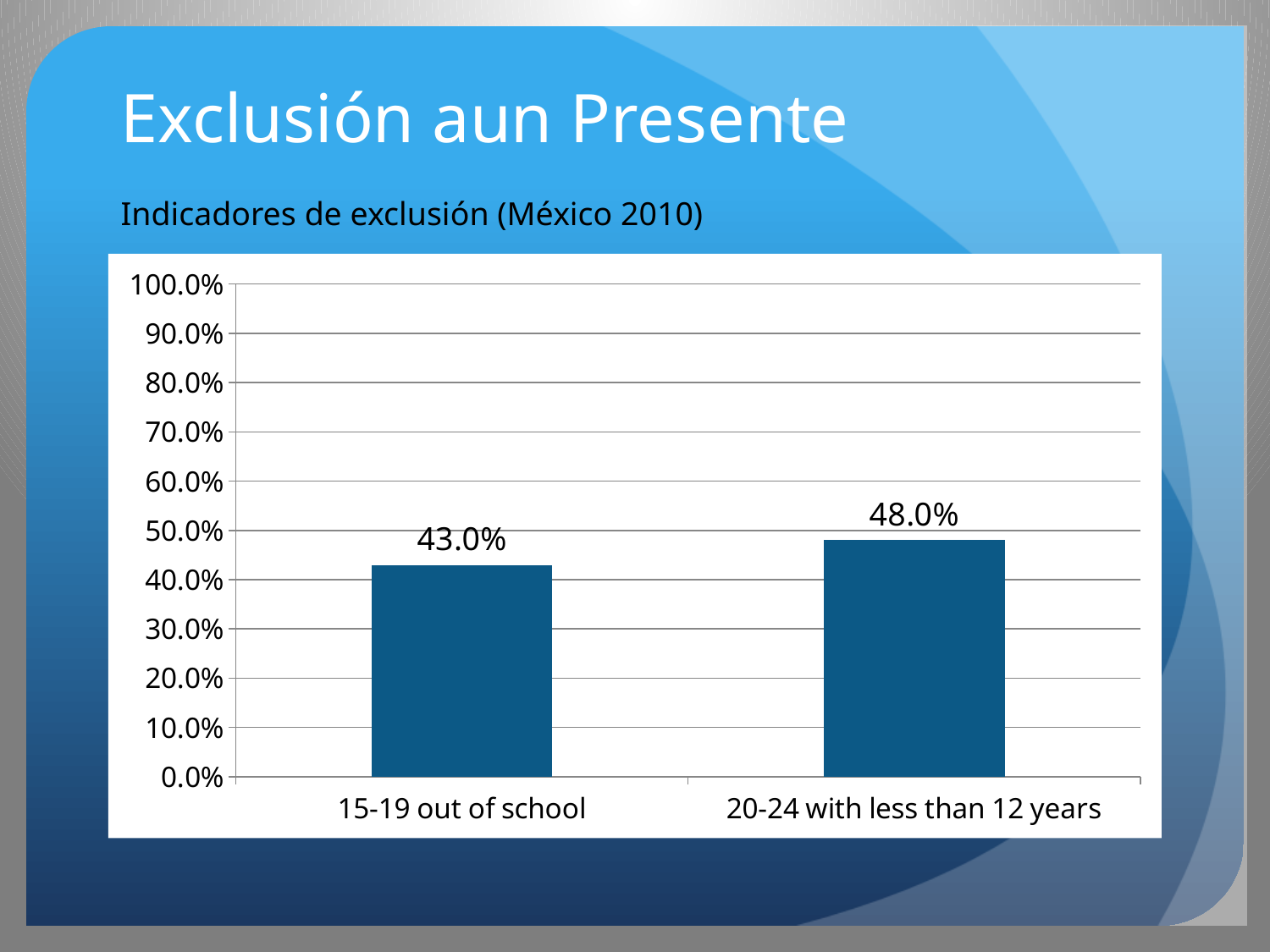
Is the value for "20-24 with less than 12 years" greater or less than 40.0%? greater Which is larger: the value for "15-19 out of school" or for "20-24 with less than 12 years"? 20-24 with less than 12 years Which category has the lowest value? 15-19 out of school What is the value for "20-24 with less than 12 years"? 48.0% Which category has the highest value? 20-24 with less than 12 years What is the value for "15-19 out of school"? 43.0% What is the difference between the values for "20-24 with less than 12 years" and "15-19 out of school"? 5.0% How many categories are shown in the chart? 2 Is the value for "15-19 out of school" greater or less than 50.0%? less What is the maximum value shown on the vertical axis? 100.0% What kind of chart is shown on the slide? Bar chart What is the text shown directly above the chart? Indicadores de exclusión (México 2010)